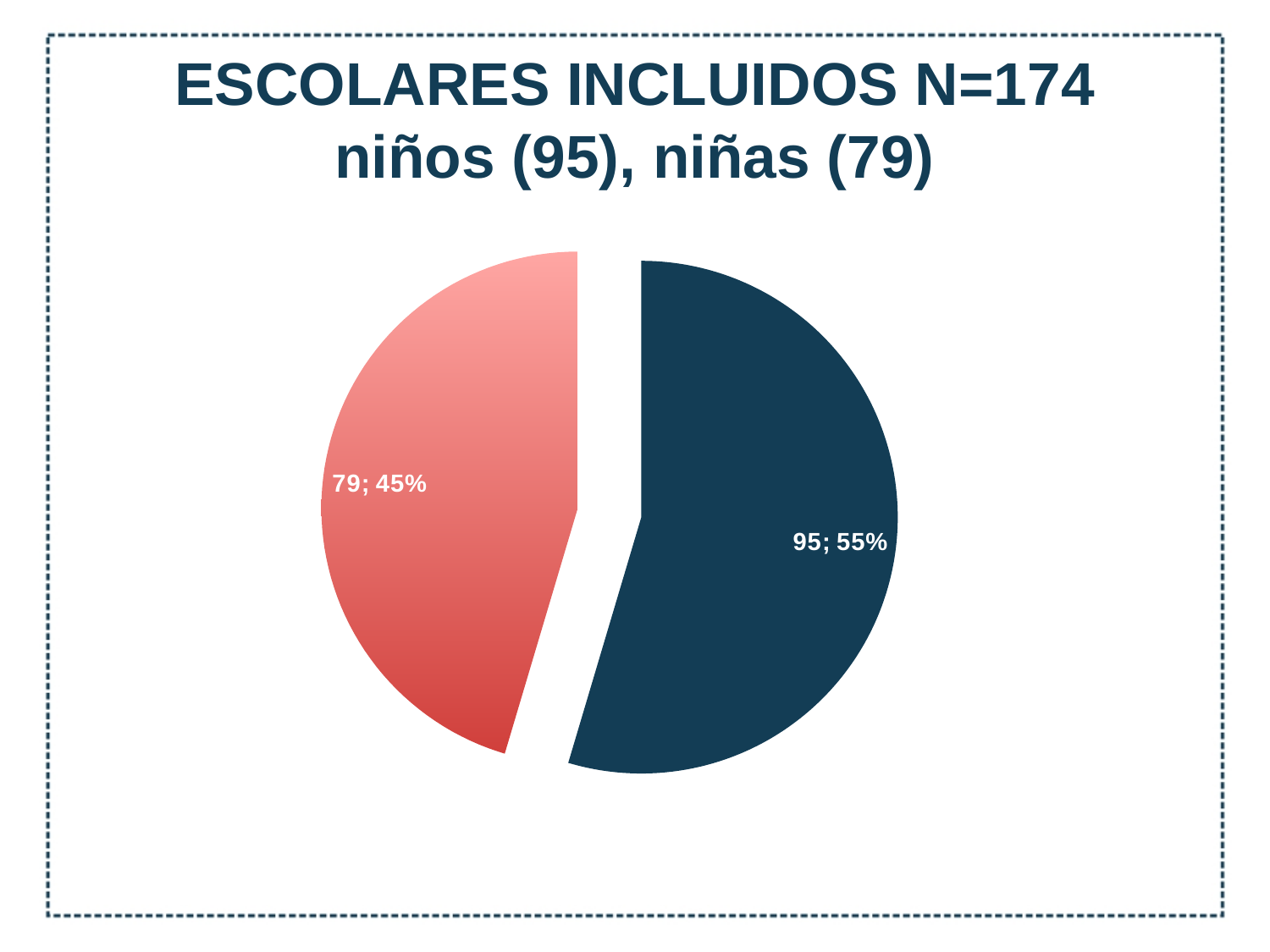
According to the slide title, how many niños are included? 95 What percentage share is shown for the dark blue slice? 55% What value is printed on the red slice of the pie chart? 79 What kind of chart is shown on the slide? pie chart How many slices does the pie chart have? 2 What value is printed on the dark blue slice of the pie chart? 95 What is the N value stated in the slide title? 174 What percentage share is shown for the red slice? 45% What is the difference between the two slice values (95 and 79)? 16 Which slice is larger, the dark blue one or the red one? the dark blue one According to the slide title, how many niñas are included? 79 What is the total of the two slice values shown on the pie chart? 174